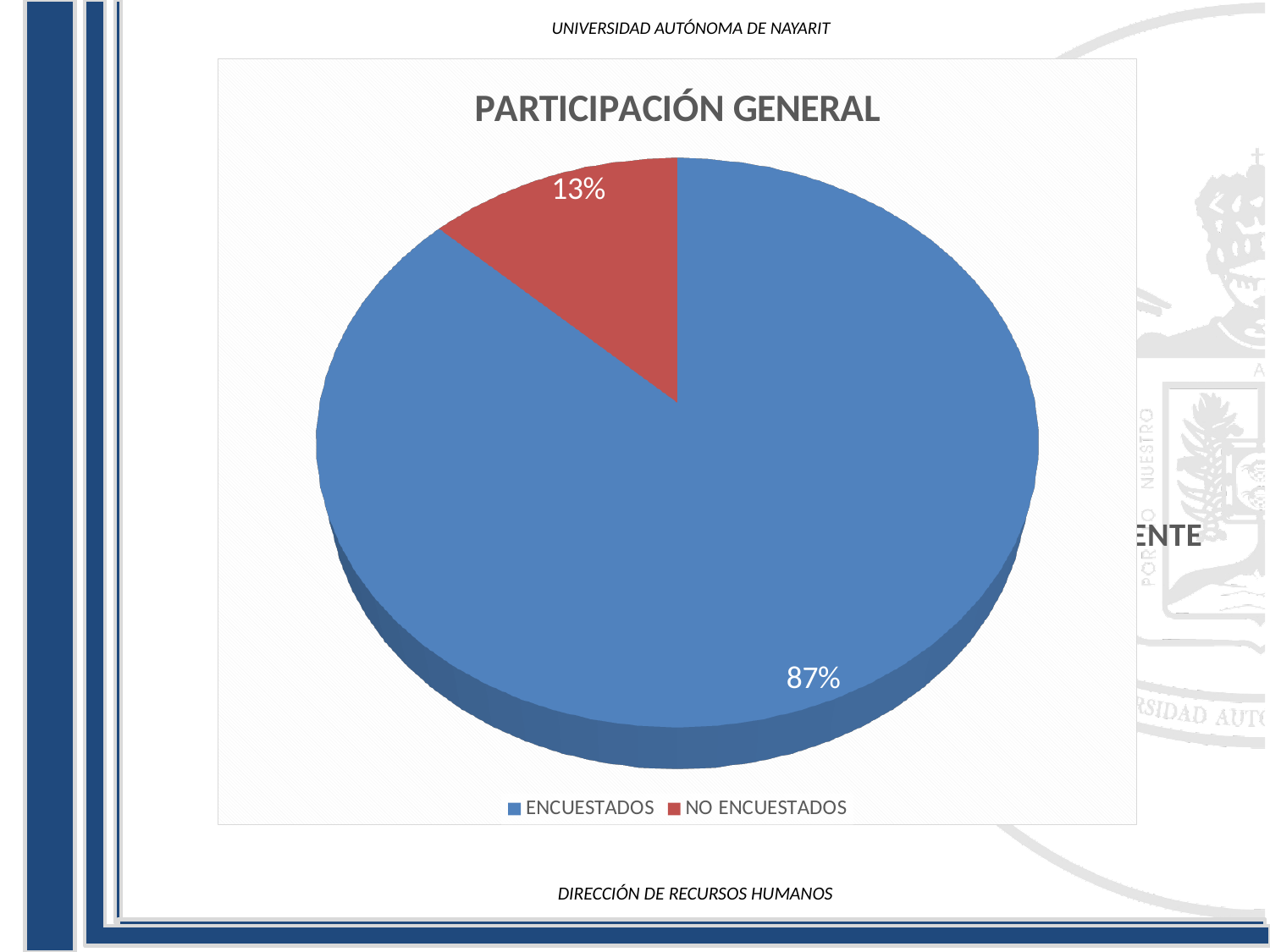
What is the difference in percentage points between the ENCUESTADOS and NO ENCUESTADOS slices? 74 Is the share for NO ENCUESTADOS greater or less than 50%? less What is the title of the chart? PARTICIPACIÓN GENERAL What colour is the NO ENCUESTADOS slice? Red What share of the pie does ENCUESTADOS represent? 87% Which slice is larger, ENCUESTADOS or NO ENCUESTADOS? ENCUESTADOS What share of the pie does NO ENCUESTADOS represent? 13% How many categories does the pie chart show? 2 What kind of chart is shown on the slide? Pie chart Which category has the largest slice of the pie? ENCUESTADOS Which category has the smallest slice of the pie? NO ENCUESTADOS